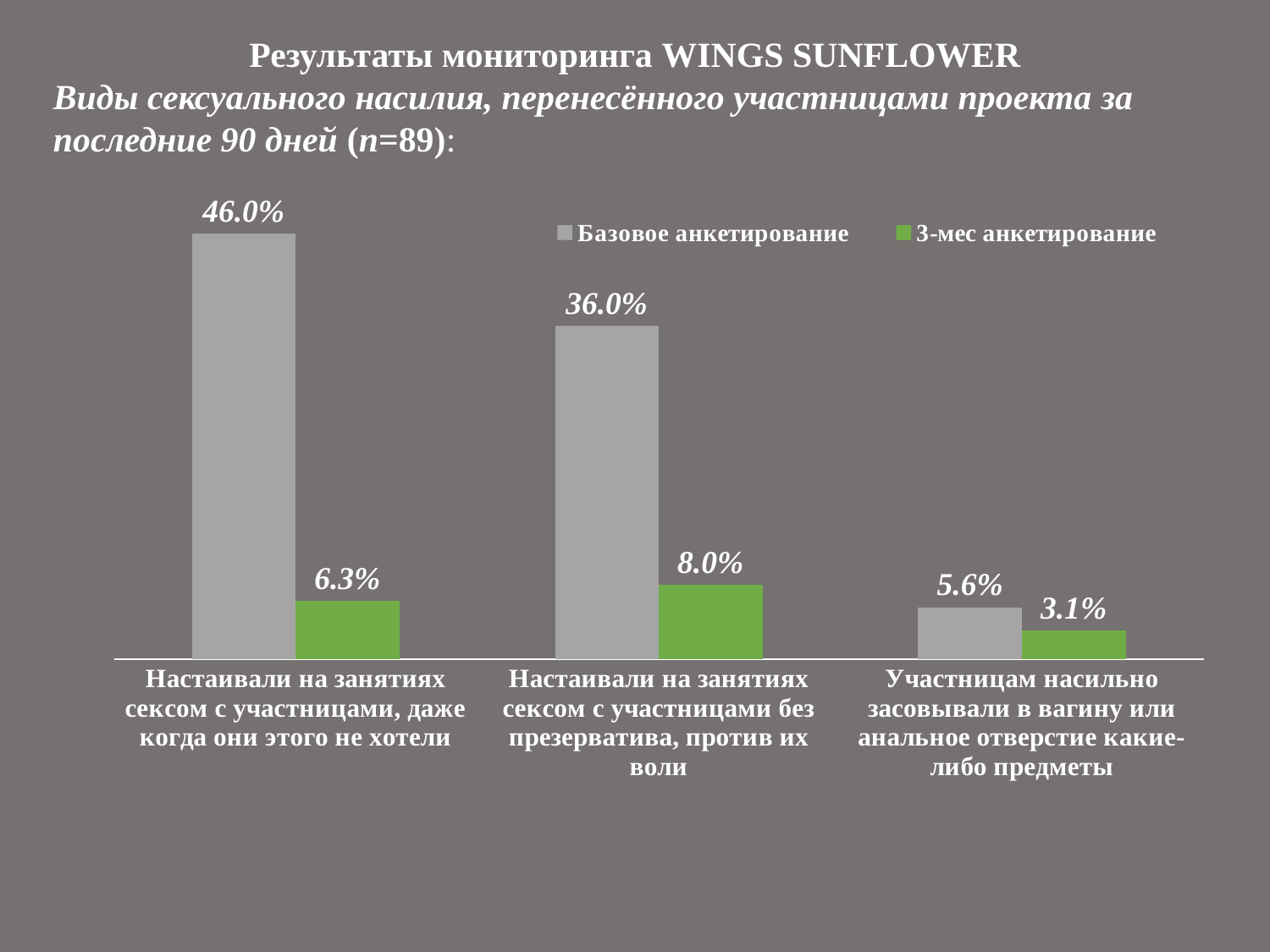
What is the value for '3-мес анкетирование' in the category 'Настаивали на занятиях сексом с участницами без презерватива, против их воли'? 8.0% Which category has the highest value for 'Базовое анкетирование'? Настаивали на занятиях сексом с участницами, даже когда они этого не хотели What is the value for '3-мес анкетирование' in the category 'Участницам насильно засовывали в вагину или анальное отверстие какие-либо предметы'? 3.1% What is the value for 'Базовое анкетирование' in the category 'Настаивали на занятиях сексом с участницами, даже когда они этого не хотели'? 46.0% How many categories are shown on the x axis of the chart? 3 What is the difference between the 'Базовое анкетирование' and '3-мес анкетирование' values for 'Настаивали на занятиях сексом с участницами, даже когда они этого не хотели'? 39.7% What is the value for 'Базовое анкетирование' in the category 'Участницам насильно засовывали в вагину или анальное отверстие какие-либо предметы'? 5.6% What kind of chart is shown on the slide? Bar chart Which is larger: the '3-мес анкетирование' value for 'Настаивали на занятиях сексом с участницами без презерватива, против их воли' or the 'Базовое анкетирование' value for 'Участницам насильно засовывали в вагину или анальное отверстие какие-либо предметы'? 3-мес анкетирование for 'Настаивали на занятиях сексом с участницами без презерватива, против их воли' (8.0%) How many series does the legend list? 2 What is the difference between the 'Базовое анкетирование' and '3-мес анкетирование' values for 'Настаивали на занятиях сексом с участницами без презерватива, против их воли'? 28.0% Which category has the lowest value for '3-мес анкетирование'? Участницам насильно засовывали в вагину или анальное отверстие какие-либо предметы